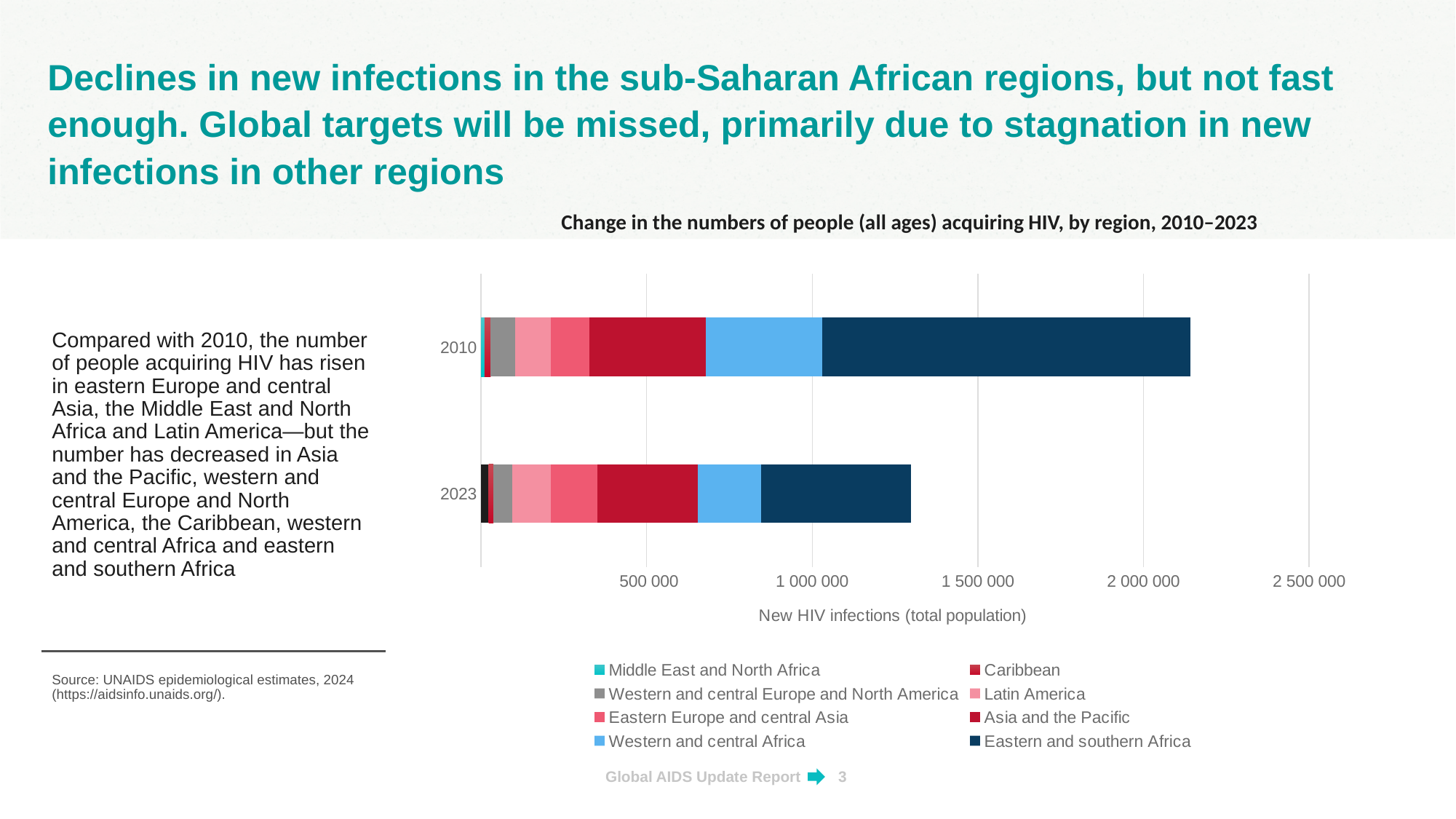
Does the total number of new HIV infections rise or fall from 2010 to 2023? Fall Which region accounts for the largest segment of the 2023 bar? Eastern and southern Africa What is the title of the chart? Change in the numbers of people (all ages) acquiring HIV, by region, 2010–2023 How many years (categories) are plotted on the chart? 2 Which region accounts for the largest segment of the 2010 bar? Eastern and southern Africa What kind of chart is shown on the slide? Stacked bar chart Is the total bar for 2023 greater or less than 1 500 000? less Is the total bar for 2023 greater or less than 1 000 000? greater How many regions does the chart legend list? 8 Which year has the larger total number of new HIV infections, 2010 or 2023? 2010 What is the label of the horizontal axis? New HIV infections (total population) Is the total bar for 2010 greater or less than 2 000 000? greater